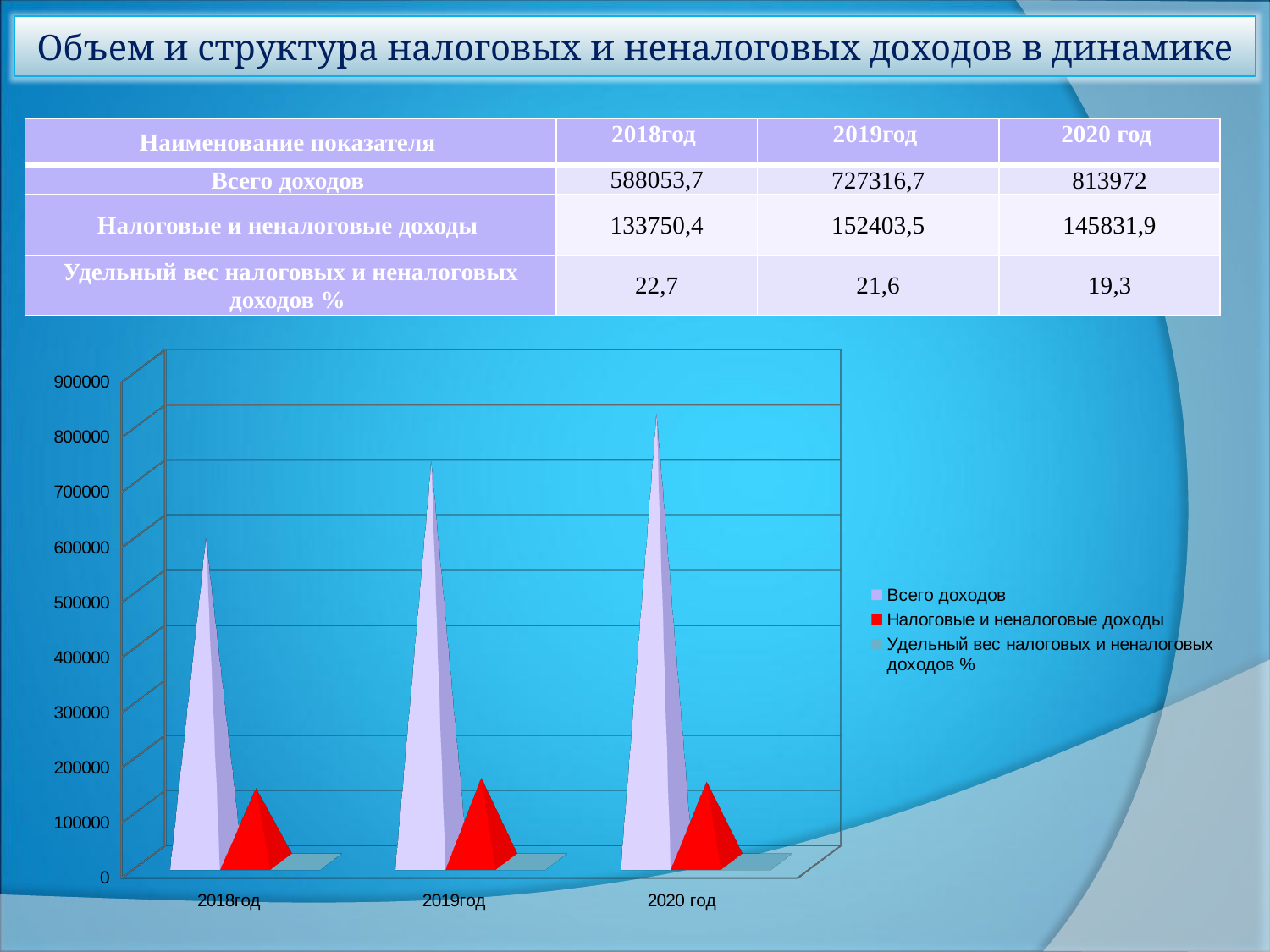
How many categories (years) are shown on the x axis of the chart? 3 Which series is shown in red in the chart? Налоговые и неналоговые доходы Is the value for Всего доходов in 2019год greater or less than 800000? less What kind of chart is shown on the slide? bar chart Is the value for Налоговые и неналоговые доходы in 2019год greater or less than 200000? less Is the value for Всего доходов in 2020 год greater or less than 700000? greater Which year has the highest value for Всего доходов in the chart? 2020 год How many series does the chart legend list? 3 In 2018год, which is larger: Всего доходов or Налоговые и неналоговые доходы? Всего доходов Do the values for Всего доходов rise or fall from 2018год to 2020 год? rise Which year has the lowest value for Всего доходов in the chart? 2018год